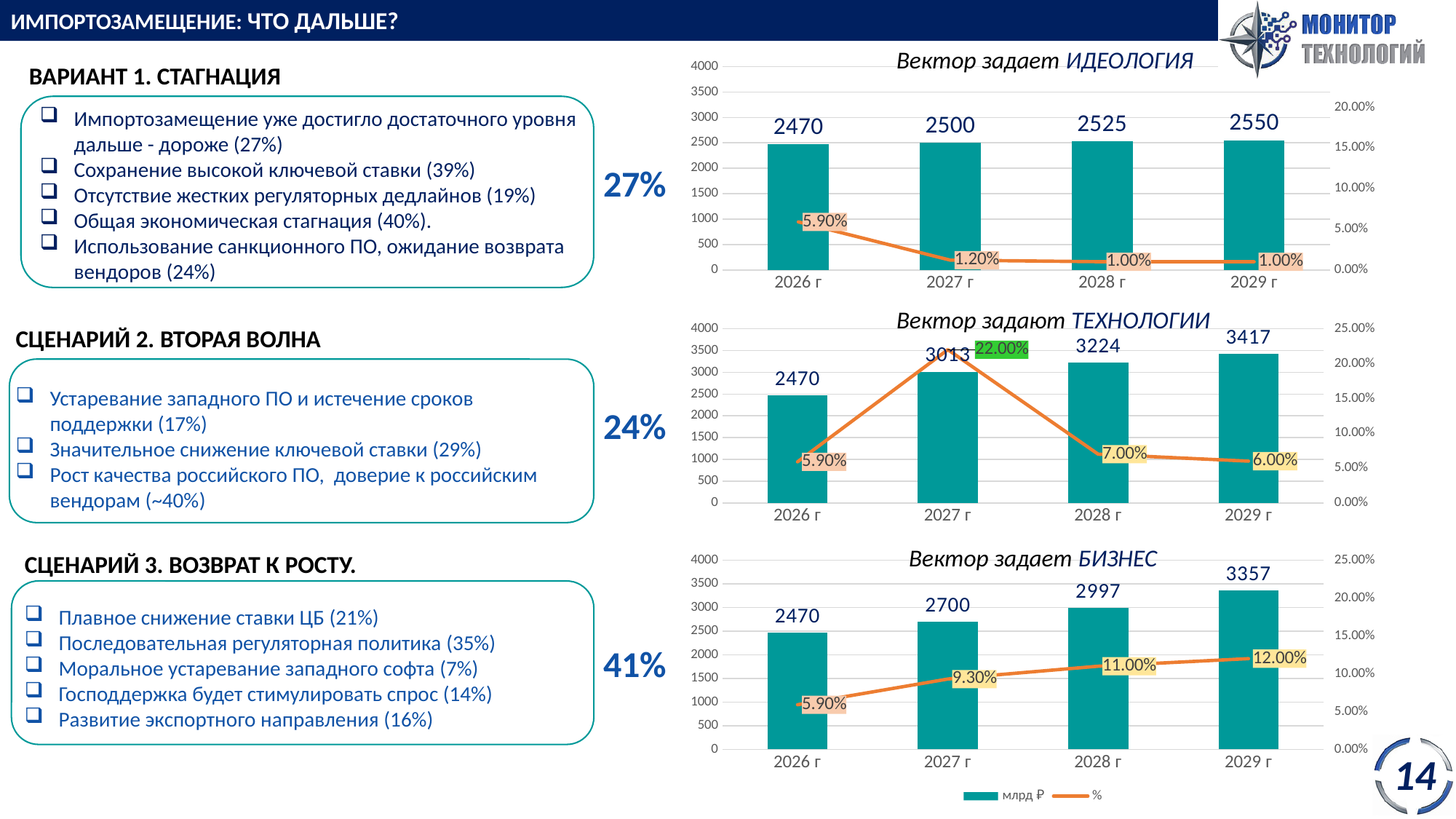
In the top chart 'Вектор задает ИДЕОЛОГИЯ', what is the bar value for 2027 г? 2500 In the middle chart 'Вектор задают ТЕХНОЛОГИИ', what percentage is shown for 2027 г? 22.00% In the top chart 'Вектор задает ИДЕОЛОГИЯ', what percentage is shown on the line for 2026 г? 5.90% What two entries does the legend below the bottom chart 'Вектор задает БИЗНЕС' list? млрд ₽ and % How many years are shown on the x axis of the bottom chart 'Вектор задает БИЗНЕС'? 4 In the bottom chart 'Вектор задает БИЗНЕС', what is the bar value for 2028 г? 2997 Which is larger: the 2029 г bar value in the middle chart 'Вектор задают ТЕХНОЛОГИИ' or in the bottom chart 'Вектор задает БИЗНЕС'? Middle chart (3417) In the top chart 'Вектор задает ИДЕОЛОГИЯ', which year has the lowest bar value? 2026 г In the middle chart 'Вектор задают ТЕХНОЛОГИИ', which year has the highest bar value? 2029 г In the bottom chart 'Вектор задает БИЗНЕС', what percentage is shown for 2029 г? 12.00% In the middle chart 'Вектор задают ТЕХНОЛОГИИ', what is the difference between the bar values for 2029 г and 2026 г? 947 In the bottom chart 'Вектор задает БИЗНЕС', do the bar values rise or fall from 2026 г to 2029 г? rise